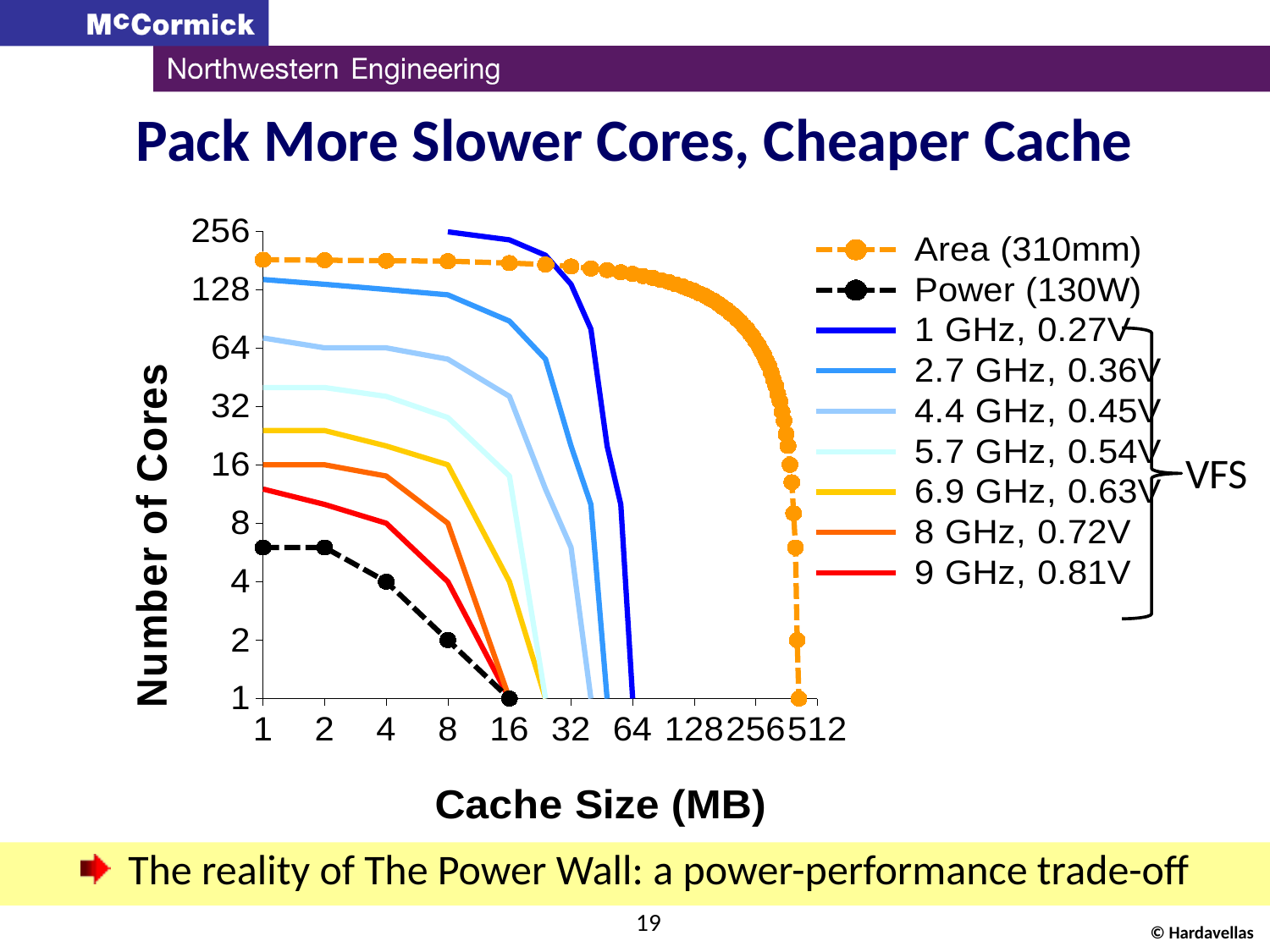
What is the label of the x axis? Cache Size (MB) What is the number of cores for the Power (130W) series at a cache size of 8 MB? 2 What kind of chart is shown on the slide? line chart How many series does the legend list? 9 Is the number of cores for the 2.7 GHz, 0.36V series at 1 MB greater or less than 128? greater What is the label of the y axis? Number of Cores What is the number of cores for the Power (130W) series at a cache size of 4 MB? 4 At a cache size of 1 MB, which series has more cores: 2.7 GHz, 0.36V or 9 GHz, 0.81V? 2.7 GHz, 0.36V What is the number of cores for the 8 GHz, 0.72V series at a cache size of 1 MB? 16 What is the number of cores for the Power (130W) series at a cache size of 16 MB? 1 Is the number of cores for the 9 GHz, 0.81V series at 1 MB greater or less than 16? less Does the Power (130W) series rise or fall as cache size increases? fall